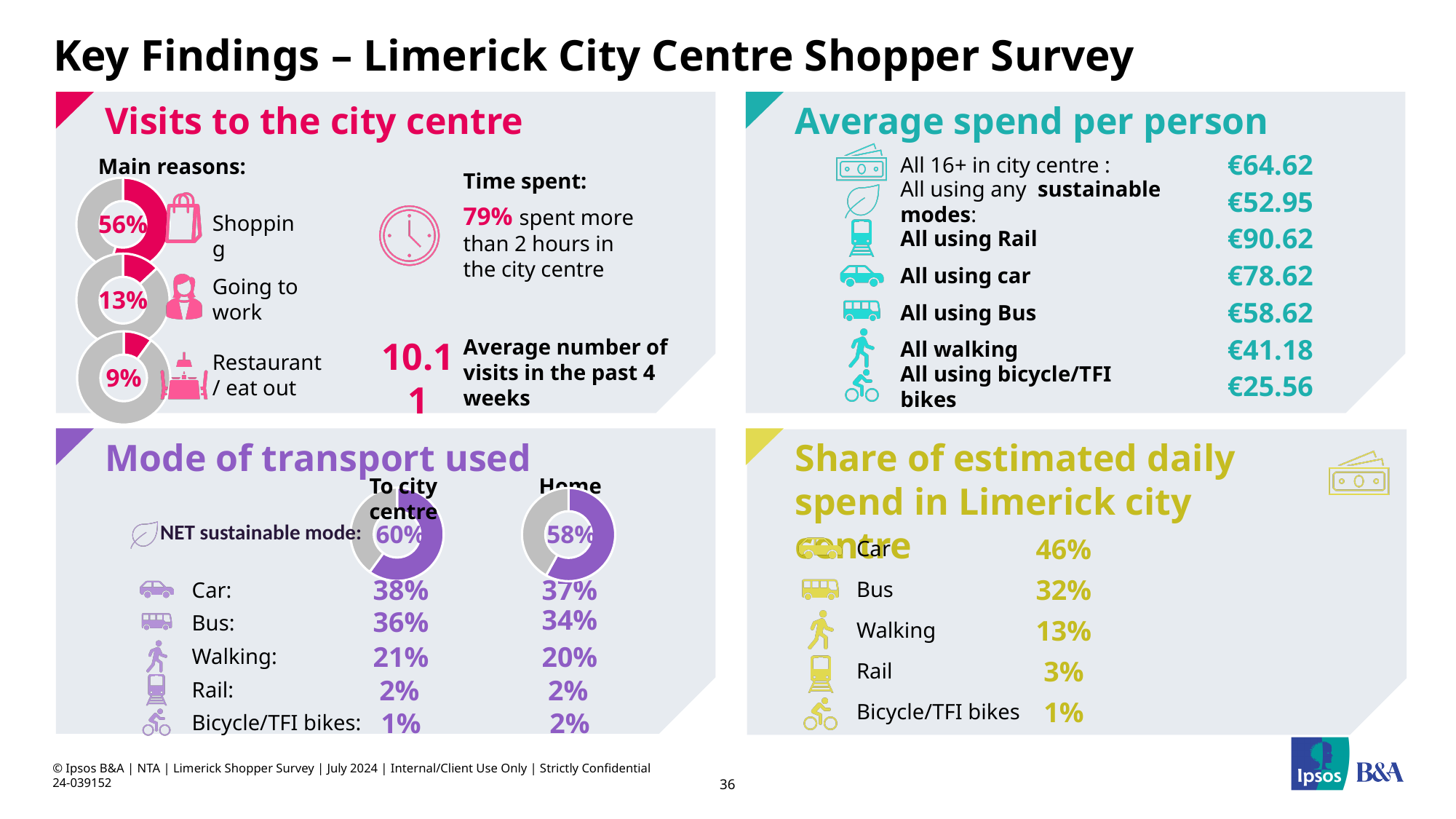
In the 'Visits to the city centre' section, what is the difference in percentage points between the Shopping and Going to work donut charts? 43 percentage points How many donut charts are shown in the 'Visits to the city centre' section? 3 In the 'Visits to the city centre' section, which main reason has the lowest percentage in its donut chart? Restaurant / eat out In the 'Visits to the city centre' section, which main reason has the highest percentage in its donut chart? Shopping In the 'Mode of transport used' section, what percentage does the 'To city centre' donut chart show for NET sustainable mode? 60% In the 'Mode of transport used' section, what percentage does the 'Home' donut chart show for NET sustainable mode? 58% In the 'Mode of transport used' section, which donut chart shows the larger NET sustainable mode share, 'To city centre' or 'Home'? To city centre In the 'Visits to the city centre' section, what percentage is shown in the donut chart for Shopping? 56% In the 'Visits to the city centre' section, what percentage is shown in the donut chart for Restaurant / eat out? 9% In the 'Visits to the city centre' section, is the Shopping share greater or less than 50%? greater What type of chart is used to show the main reasons for visiting the city centre? Donut (pie) chart In the 'Visits to the city centre' section, what percentage is shown in the donut chart for Going to work? 13%